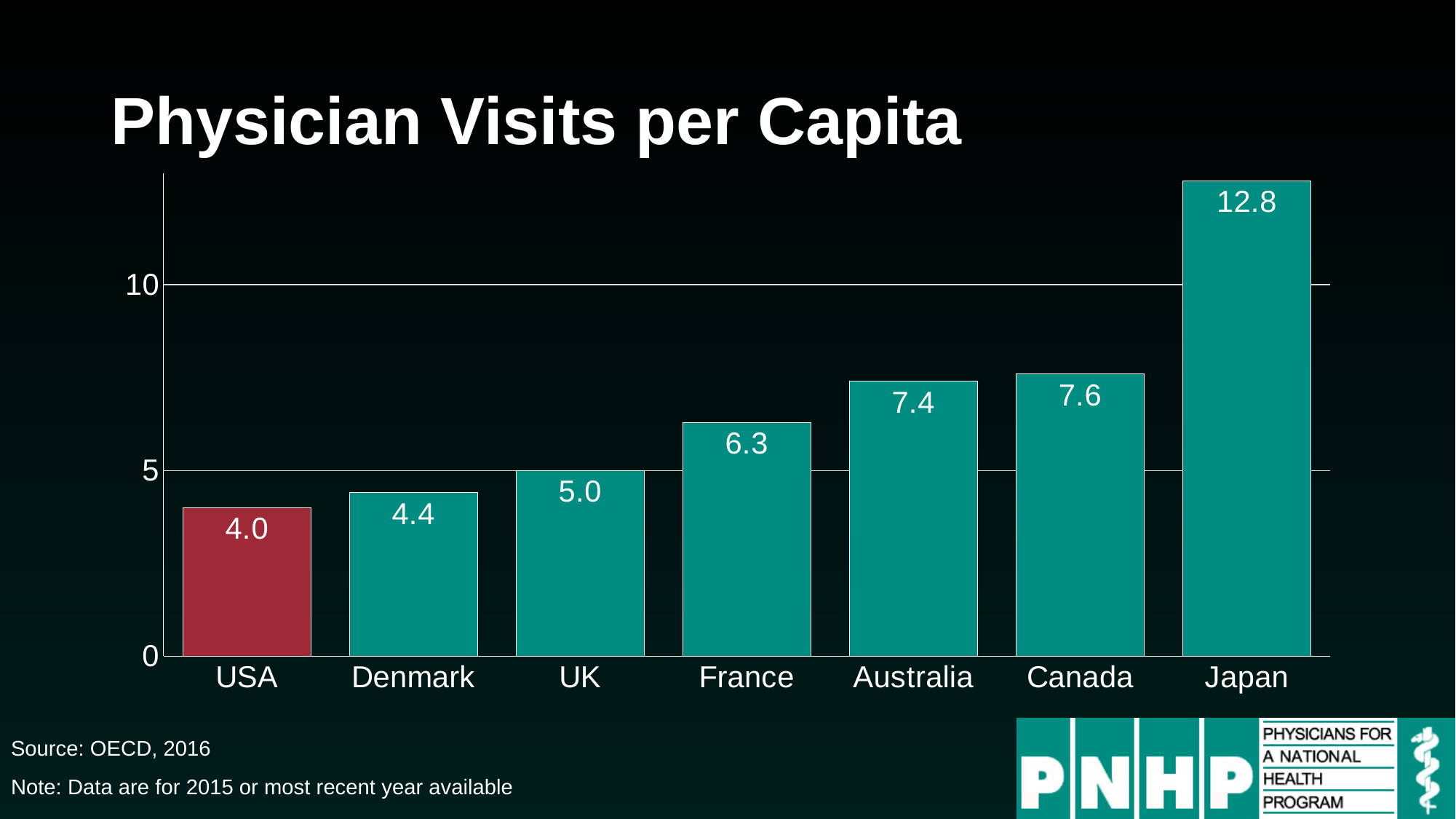
Which country has the lowest number of physician visits per capita? USA What is the difference between the values for Canada and Australia? 0.2 Is the value for Australia greater or less than 5? greater What kind of chart is shown on the slide? Bar chart What is the difference between the values for Japan and the USA? 8.8 What is the value for the USA? 4.0 Which country has the highest number of physician visits per capita? Japan What is the value for Japan? 12.8 Which is larger, the value for Denmark or the value for France? France How many countries are shown in the chart? 7 What is the value for France? 6.3 Which country's bar is shown in a different colour (red) from the others? USA